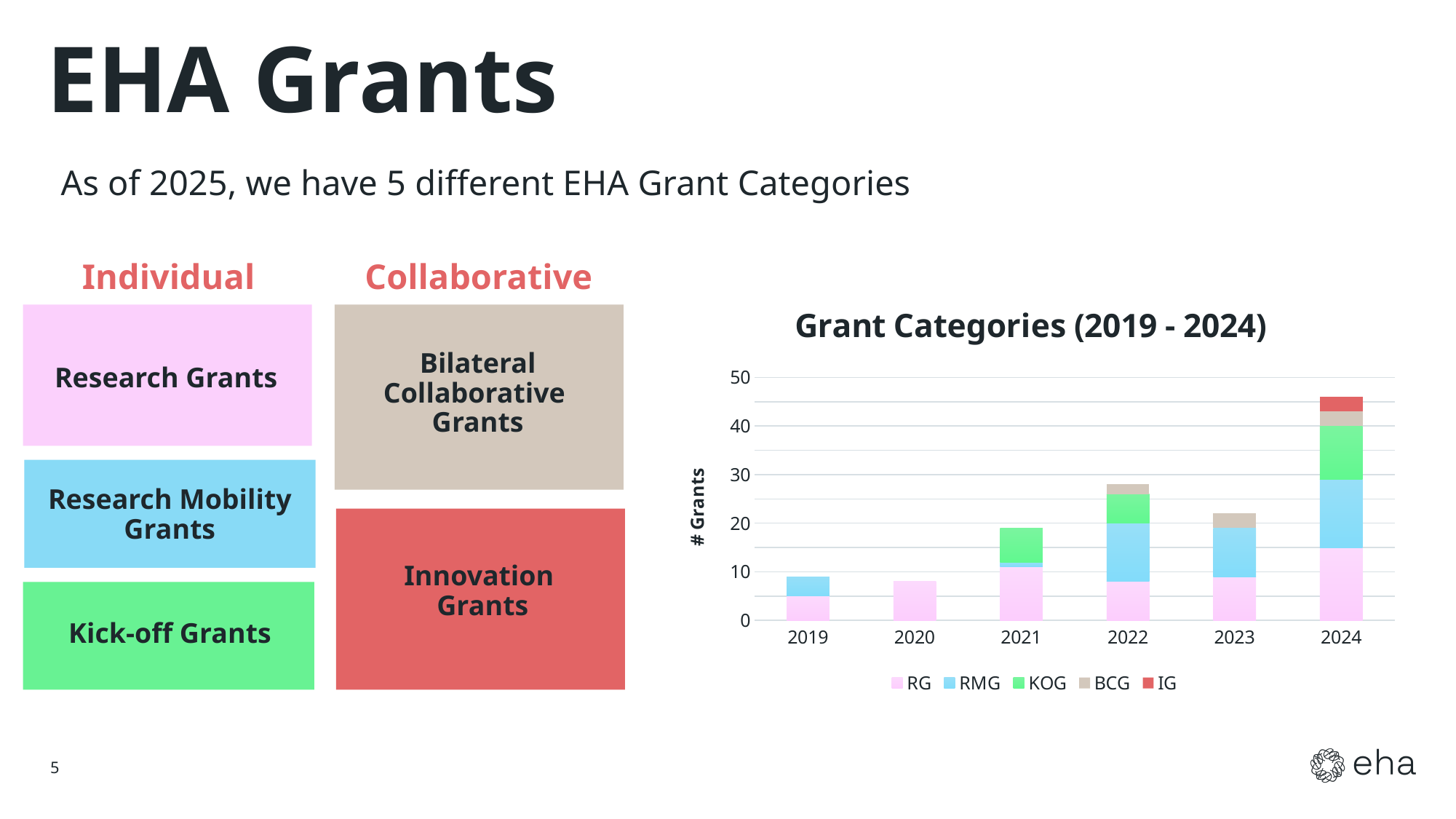
Which year has a higher total number of grants, 2022 or 2023? 2022 How many series does the legend of the Grant Categories chart list? 5 What kind of chart is shown on the slide? Stacked bar chart Is the total number of grants for 2024 greater or less than 40? greater Is the total number of grants for 2022 greater or less than 20? greater How many years are shown on the x axis of the Grant Categories chart? 6 Does the total number of grants rise or fall from 2022 to 2023? fall Is the total number of grants for 2020 greater or less than 10? less What is the title of the chart? Grant Categories (2019 - 2024) Which year has a higher total number of grants, 2021 or 2024? 2024 Which year has the highest total number of grants in the Grant Categories chart? 2024 What is the label on the y axis of the chart? # Grants